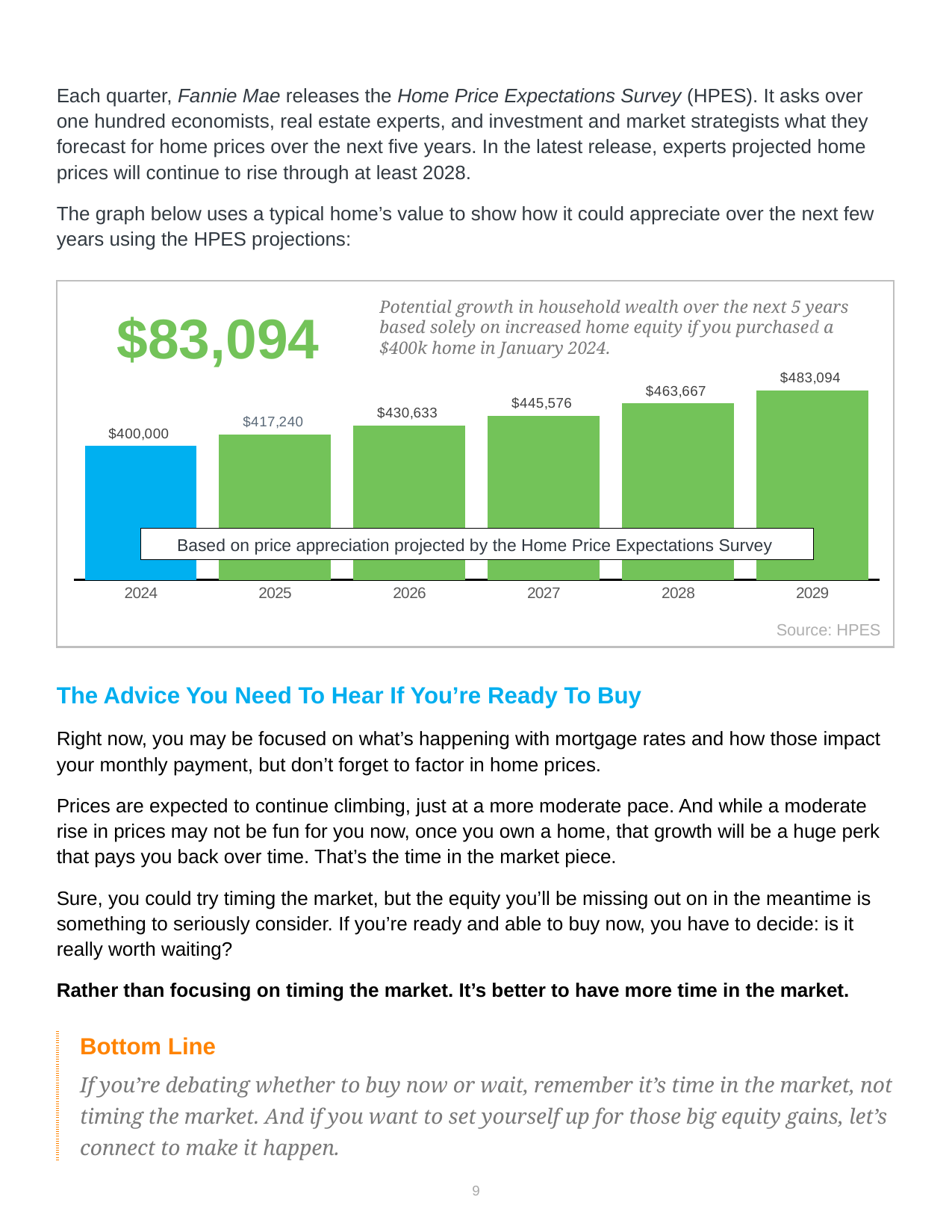
What kind of chart is shown on the slide? Bar chart Which year has the highest home value in the chart? 2029 What is the home value shown for 2024? $400,000 What is the source cited for the chart? HPES What is the difference between the home value in 2026 and the home value in 2025? $13,393 What is the projected home value for 2027? $445,576 Which year has the lowest home value in the chart? 2024 What is the projected home value for 2029? $483,094 Do the home values rise or fall from 2024 to 2029? Rise Which is larger, the home value in 2028 or the home value in 2026? 2028 How many years are shown on the x axis of the chart? 6 What is the difference between the home value in 2029 and the home value in 2024? $83,094